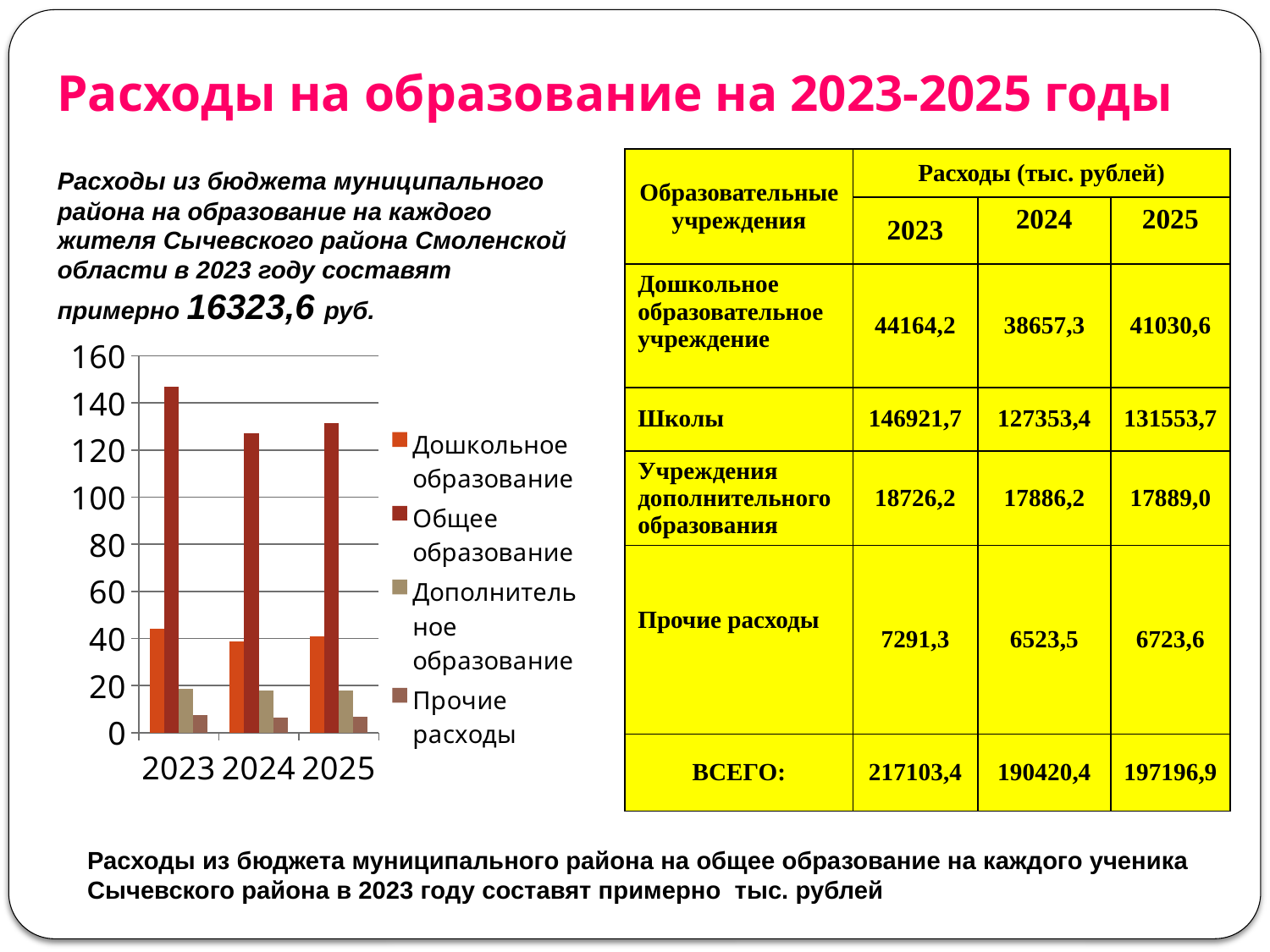
Is the value for Прочие расходы in 2025 greater or less than 20? less What kind of chart is shown on the slide? bar chart In 2025, which is larger: Дополнительное образование or Прочие расходы? Дополнительное образование Which series has the highest bar in 2025? Общее образование Which series has the lowest bar in 2023? Прочие расходы Does the bar for Общее образование rise or fall from 2023 to 2024? fall Is the value for Общее образование in 2023 greater or less than 140? greater How many years are shown on the x axis of the chart? 3 How many series does the chart legend list? 4 In which year is the bar for Общее образование the tallest? 2023 Is the value for Дошкольное образование in 2023 greater or less than 60? less